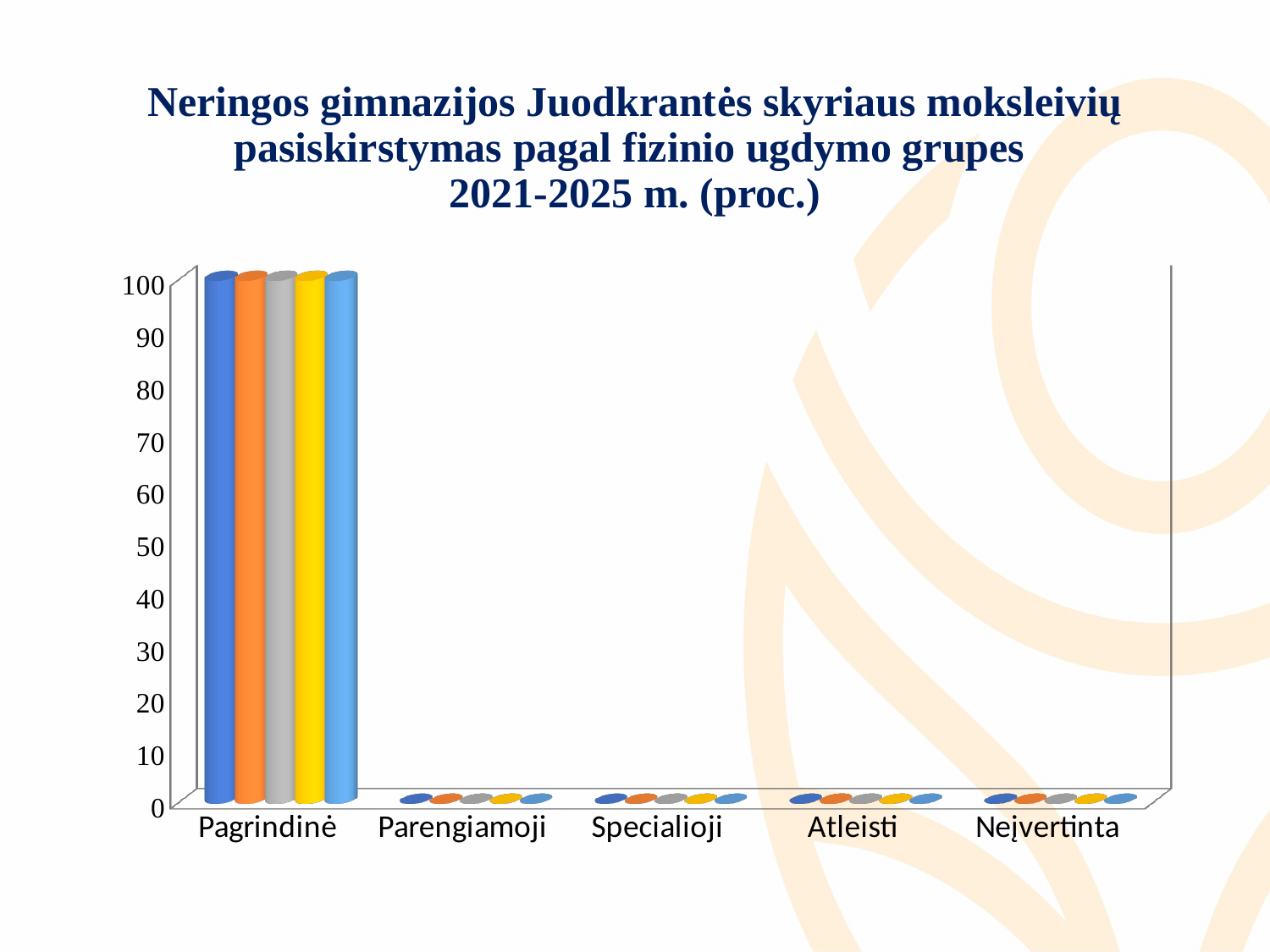
What value do the bars for Parengiamoji show? 0 What kind of chart is shown on the slide? bar chart How many bars are plotted for each category in the chart? 5 What years does the chart title say the data covers? 2021-2025 m. What value do the bars for Pagrindinė reach on the axis? 100 Is the value for Atleisti greater or less than 10? less Which is larger, the value for Pagrindinė or the value for Specialioji? Pagrindinė How many categories are shown on the x axis of the chart? 5 What value do the bars for Neįvertinta show? 0 Which category has the highest values in the chart? Pagrindinė What is the difference between the value for Pagrindinė and the value for Atleisti? 100 Is the value for Pagrindinė greater or less than 50? greater